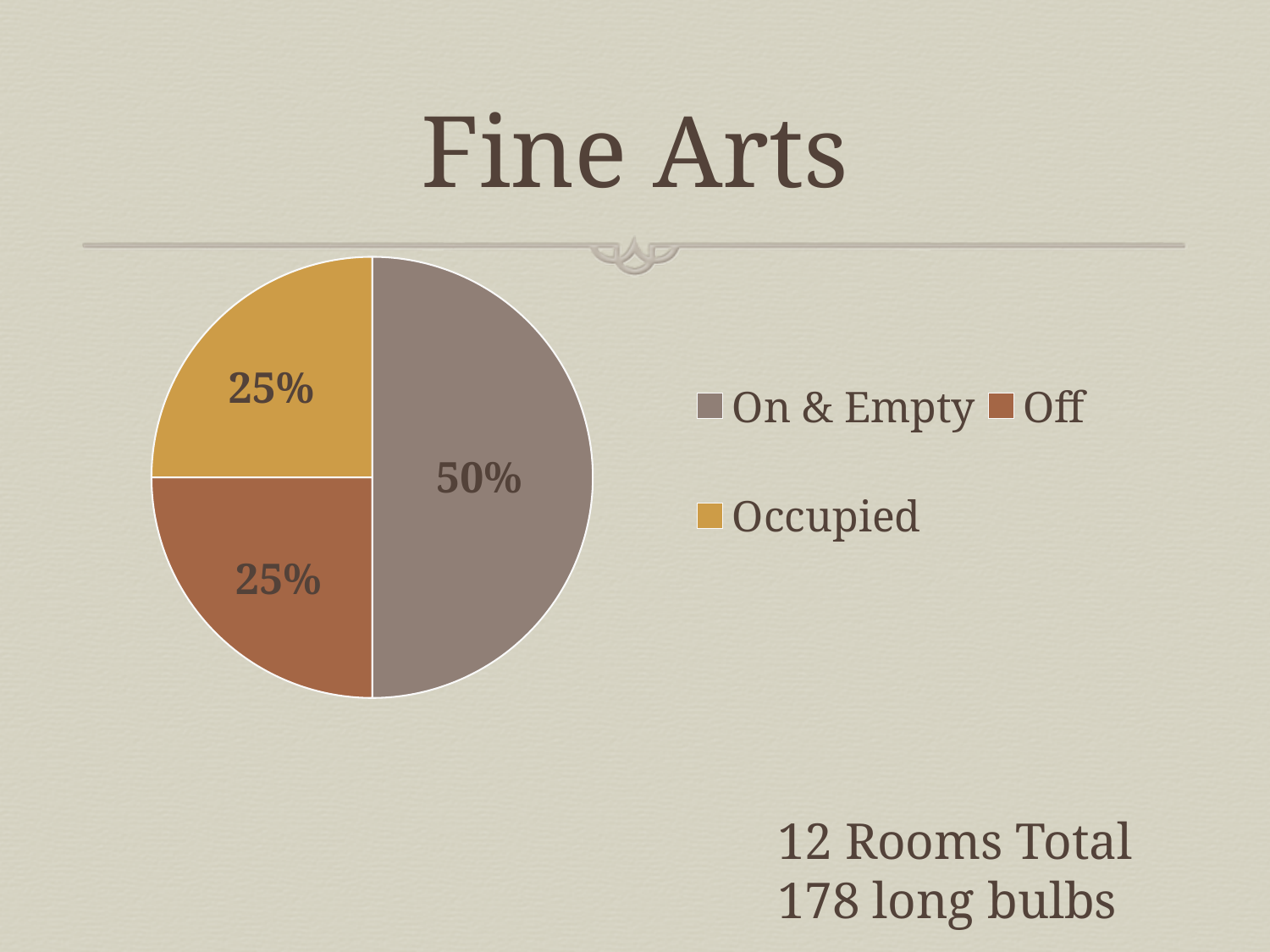
How many entries does the legend list? 3 What kind of chart is shown on the slide? pie chart Is the share for On & Empty greater or less than 40%? greater What share of the pie is labelled On & Empty? 50% What is the difference between the On & Empty share and the Off share? 25% How many slices does the pie chart have? 3 Which category has the largest slice of the pie? On & Empty What is the title of the slide containing the pie chart? Fine Arts What share of the pie is labelled Occupied? 25% What colour is the Occupied slice in the pie chart? gold/yellow Which is larger, the On & Empty slice or the Occupied slice? On & Empty What share of the pie is labelled Off? 25%